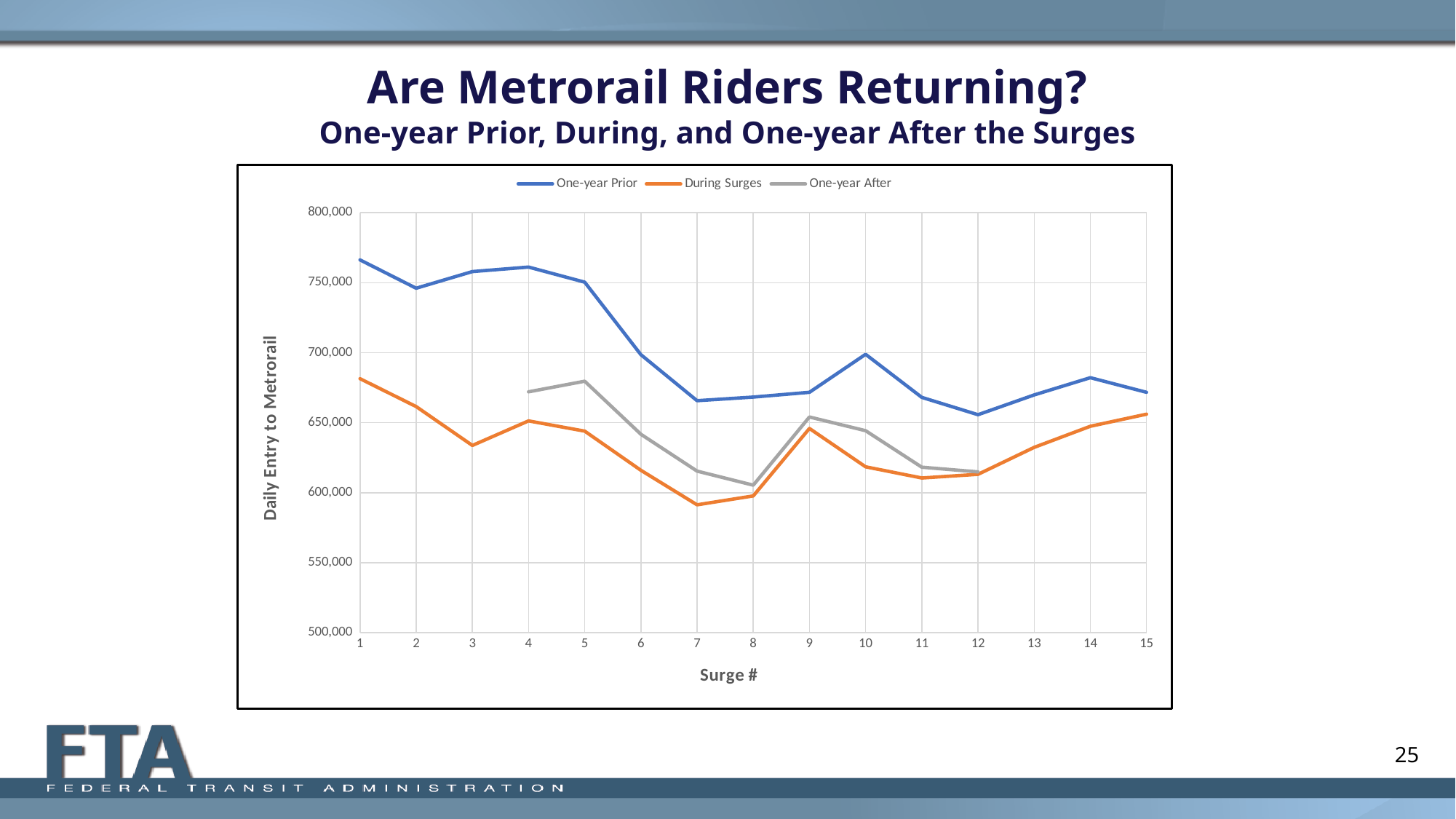
At surge 5, which series has the higher value: One-year After or During Surges? One-year After What kind of chart is shown on the slide? Line chart Is the During Surges value at surge 7 greater or less than 600,000? less Is the One-year Prior value at surge 1 greater or less than 750,000? greater Does the During Surges series rise or fall from surge 12 to surge 15? Rise How many surges are shown along the x axis? 15 What is the label on the y axis of the chart? Daily Entry to Metrorail Is the One-year After value at surge 4 greater or less than 650,000? greater Does the One-year Prior series rise or fall from surge 1 to surge 7? Fall At surge 7, which series has the higher value: One-year Prior or During Surges? One-year Prior How many series does the legend list? 3